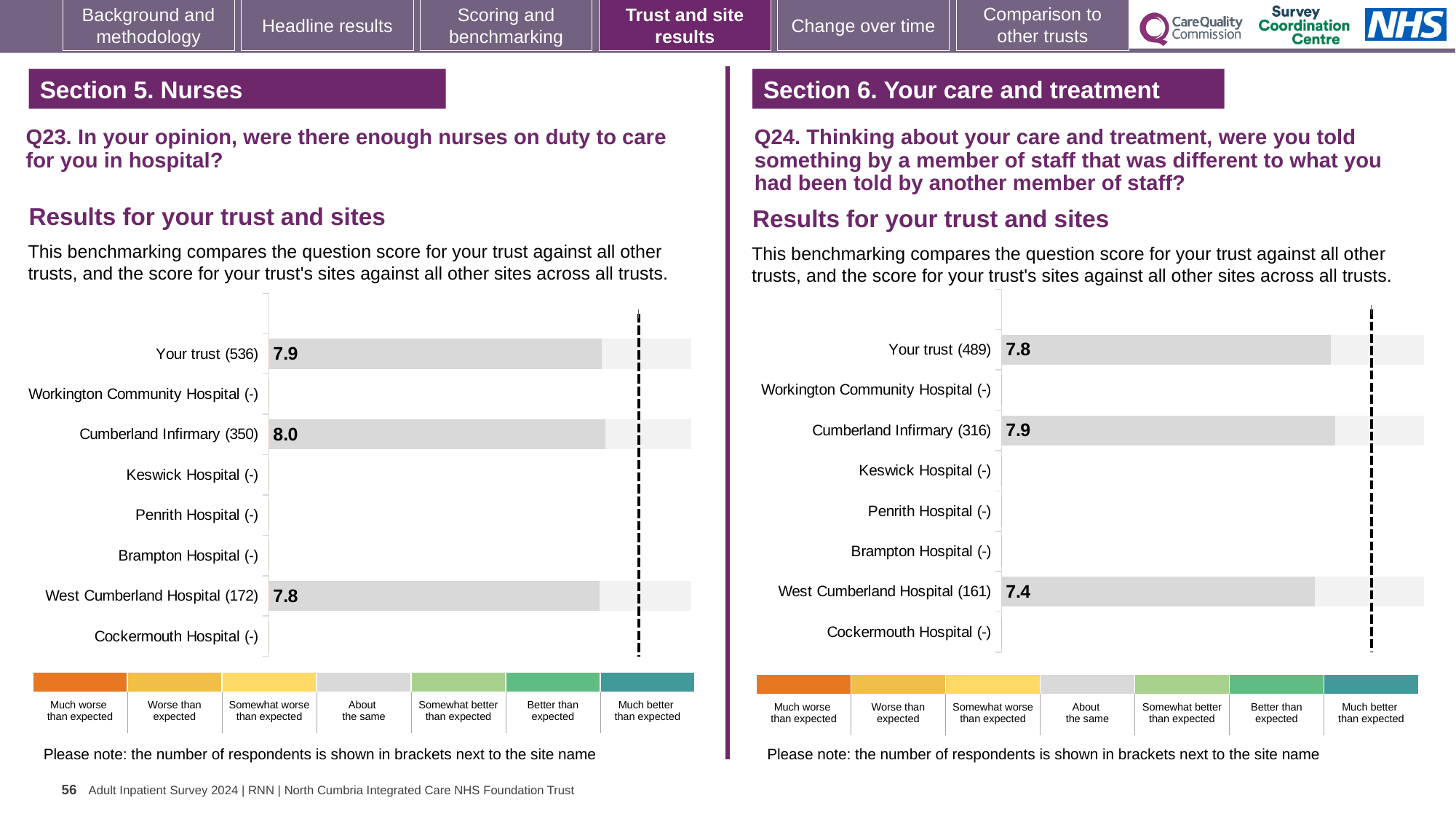
On the Q23 chart (left), what is the difference between the scores for Cumberland Infirmary (350) and West Cumberland Hospital (172)? 0.2 On the Q24 chart (right), which site with a plotted score has the lowest value? West Cumberland Hospital (161) On the Q23 chart (left), what is the score for Your trust (536)? 7.9 On the Q23 chart (left), what is the score for Cumberland Infirmary (350)? 8.0 On the Q24 chart (right), what is the score for Cumberland Infirmary (316)? 7.9 On the Q24 chart (right), which is larger: the score for Cumberland Infirmary (316) or West Cumberland Hospital (161)? Cumberland Infirmary (316) On the Q24 chart (right), what is the score for West Cumberland Hospital (161)? 7.4 On the Q24 chart (right), what is the difference between the scores for Your trust (489) and West Cumberland Hospital (161)? 0.4 On the Q24 chart (right), what is the score for Your trust (489)? 7.8 What kind of chart is used on the Q23 chart (left)? Bar chart On the Q23 chart (left), which site with a plotted score has the highest value? Cumberland Infirmary (350) On the Q23 chart (left), what is the score for West Cumberland Hospital (172)? 7.8